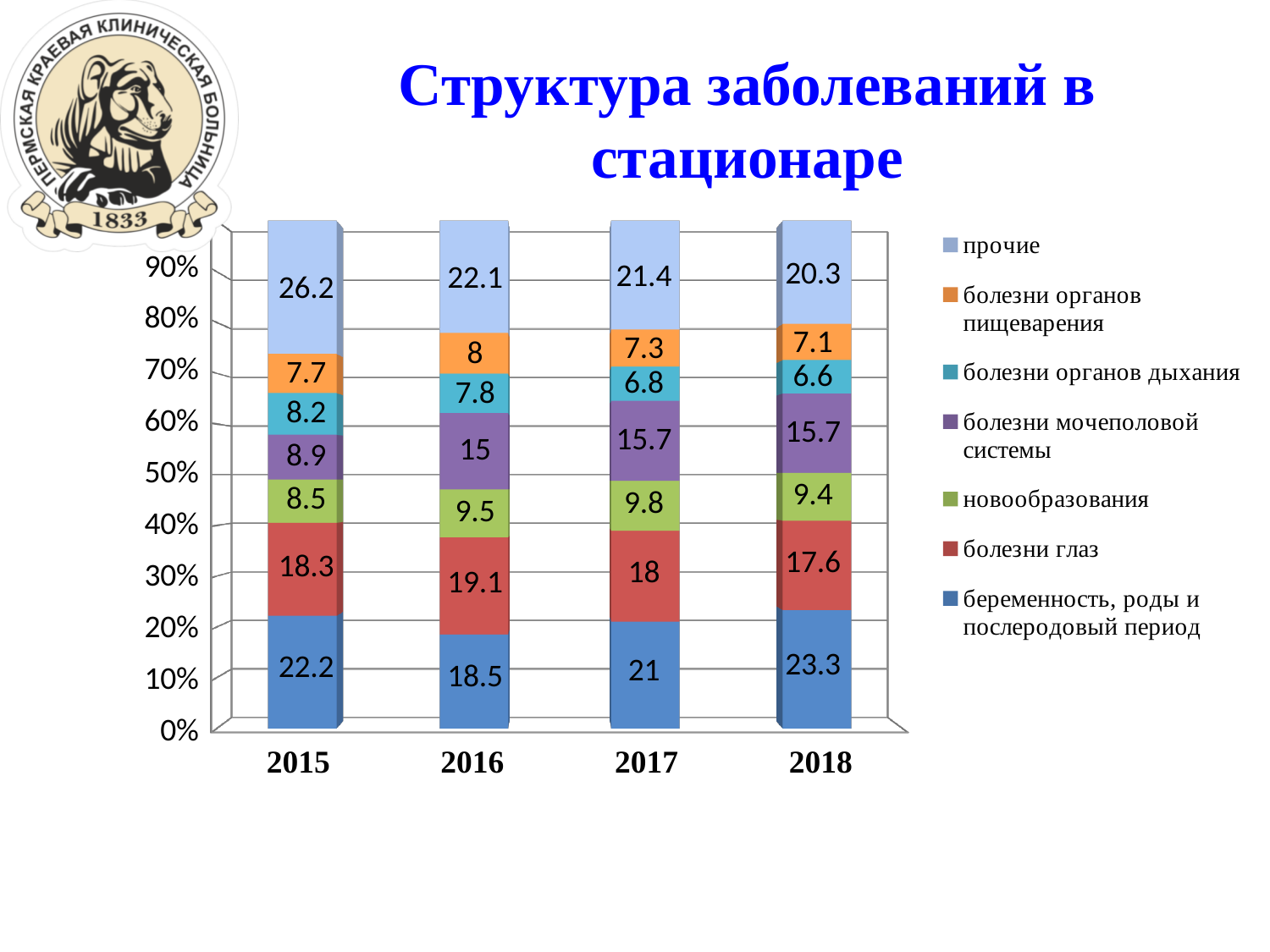
What is the difference between the «прочие» values for 2015 and 2018? 5.9 What kind of chart is shown on the slide? Stacked bar chart Does the value for «прочие» rise or fall from 2015 to 2018? Fall In which year is the value for «болезни органов пищеварения» the lowest? 2018 In which year is the value for «прочие» the highest? 2015 Which is larger: the value for «беременность, роды и послеродовый период» in 2015 or in 2016? 2015 What is the value for «прочие» in 2015? 26.2 How many years are shown on the x axis? 4 What is the value for «болезни мочеполовой системы» in 2016? 15 What is the value for «болезни органов дыхания» in 2017? 6.8 What is the value for «беременность, роды и послеродовый период» in 2018? 23.3 How many series does the legend list? 7